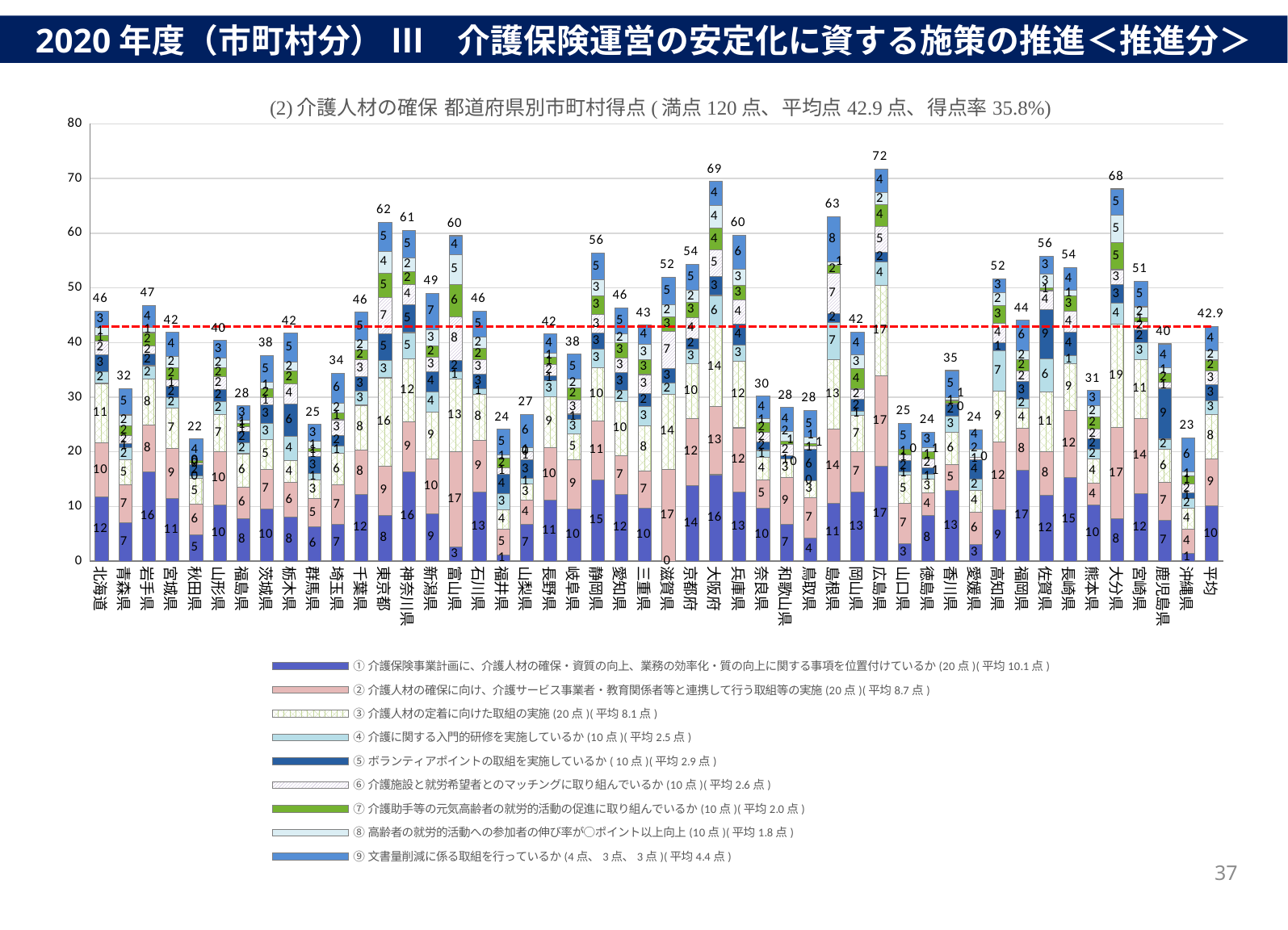
Is the total score for 秋田県 greater or less than 30? less What is the total score labeled above the bar for 広島県? 72 What value is labeled for the 平均 bar at the far right of the chart? 42.9 Which prefecture has the lowest total score in the chart? 秋田県 Which prefecture has the highest total score in the chart? 広島県 What kind of chart is shown on the slide? Stacked bar chart What is the difference between the total scores of 広島県 and 秋田県? 50 Which has a higher total score, 東京都 or 神奈川県? 東京都 What is the difference between the total scores of 大阪府 and 大分県? 1 What is the value of the bottom segment (series ①) for 岩手県? 16 What is the total score labeled above the bar for 沖縄県? 23 How many series does the legend list? 9